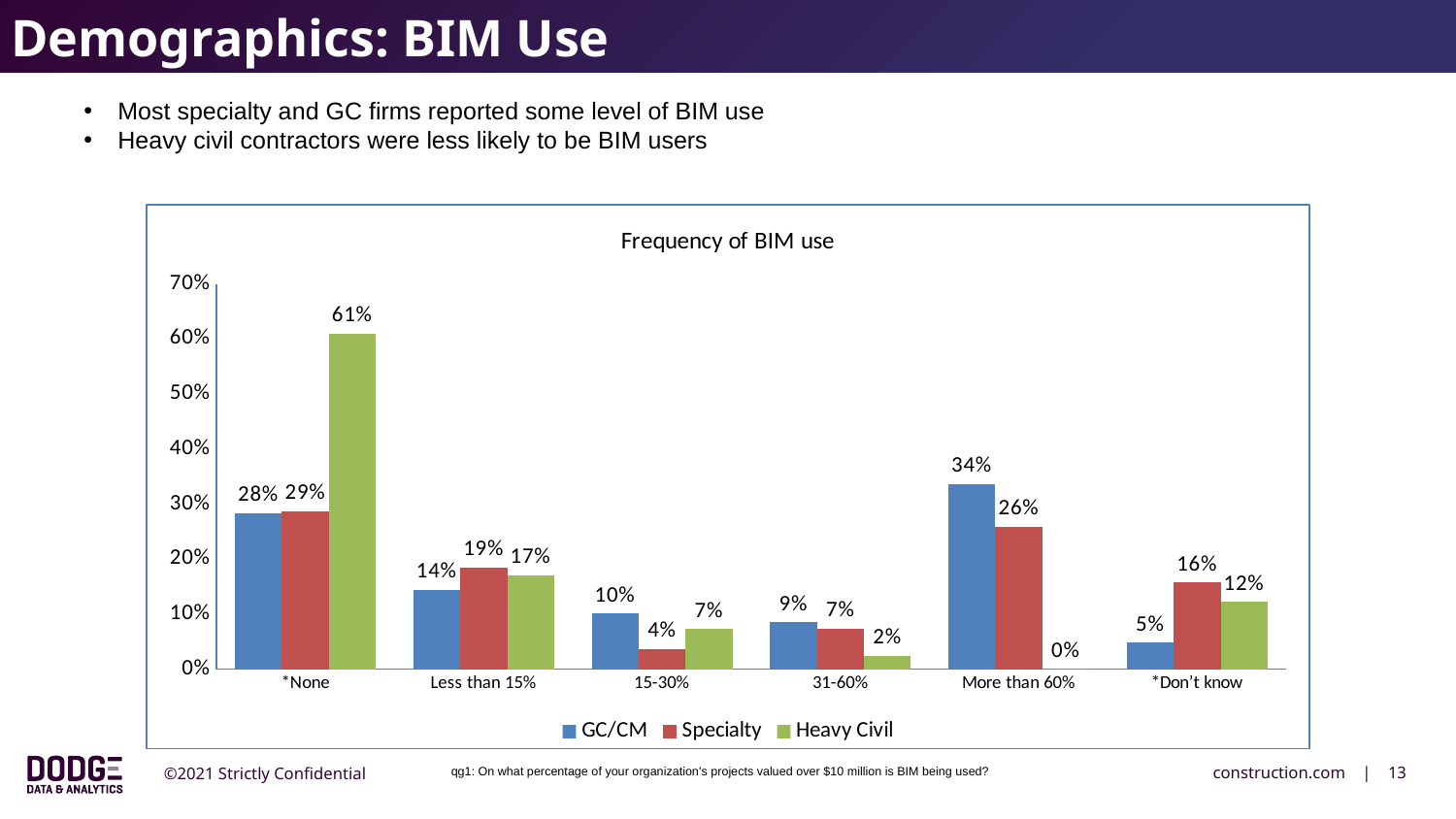
Which category has the highest Heavy Civil value? *None Which category has the lowest GC/CM value? *Don't know What is the GC/CM value for the More than 60% category? 34% Which is larger for the 15-30% category, the GC/CM value or the Specialty value? GC/CM How many series does the legend list? 3 What is the Heavy Civil value for the *None category? 61% What is the Heavy Civil value for the More than 60% category? 0% How many categories are shown on the x axis? 6 What type of chart is shown? Bar chart Is the Heavy Civil value for *None greater or less than 50%? greater What is the difference between the Specialty and GC/CM values for the *Don't know category? 11% What is the Specialty value for the Less than 15% category? 19%